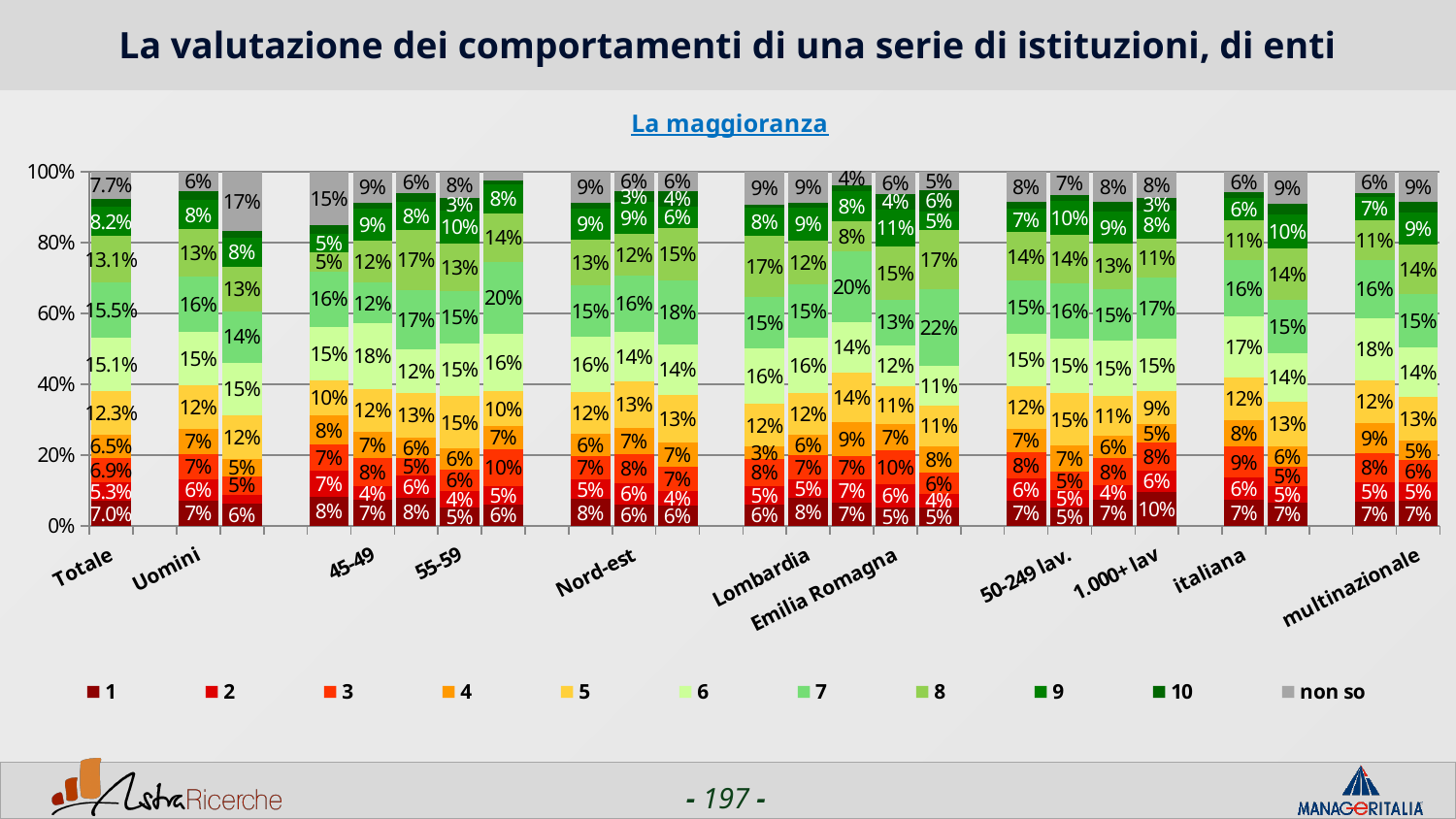
What is the highest value shown on the y axis? 100% What is the value of series 1 (the bottom segment) for Uomini? 7% What kind of chart is shown on the slide? stacked bar chart For Totale, what is the difference between series 5 (12.3%) and series 1 (7.0%)? 5.3% For Totale, which is larger: series 5 or series 1? series 5 How many series does the legend list? 11 What is the value of series 5 (yellow segment) for Totale? 12.3% What is the value of series 1 (the bottom segment) for Totale? 7.0% What is the subtitle shown above the chart? La maggioranza What is the last entry in the legend? non so What is the value of series 5 (yellow segment) for Uomini? 12%